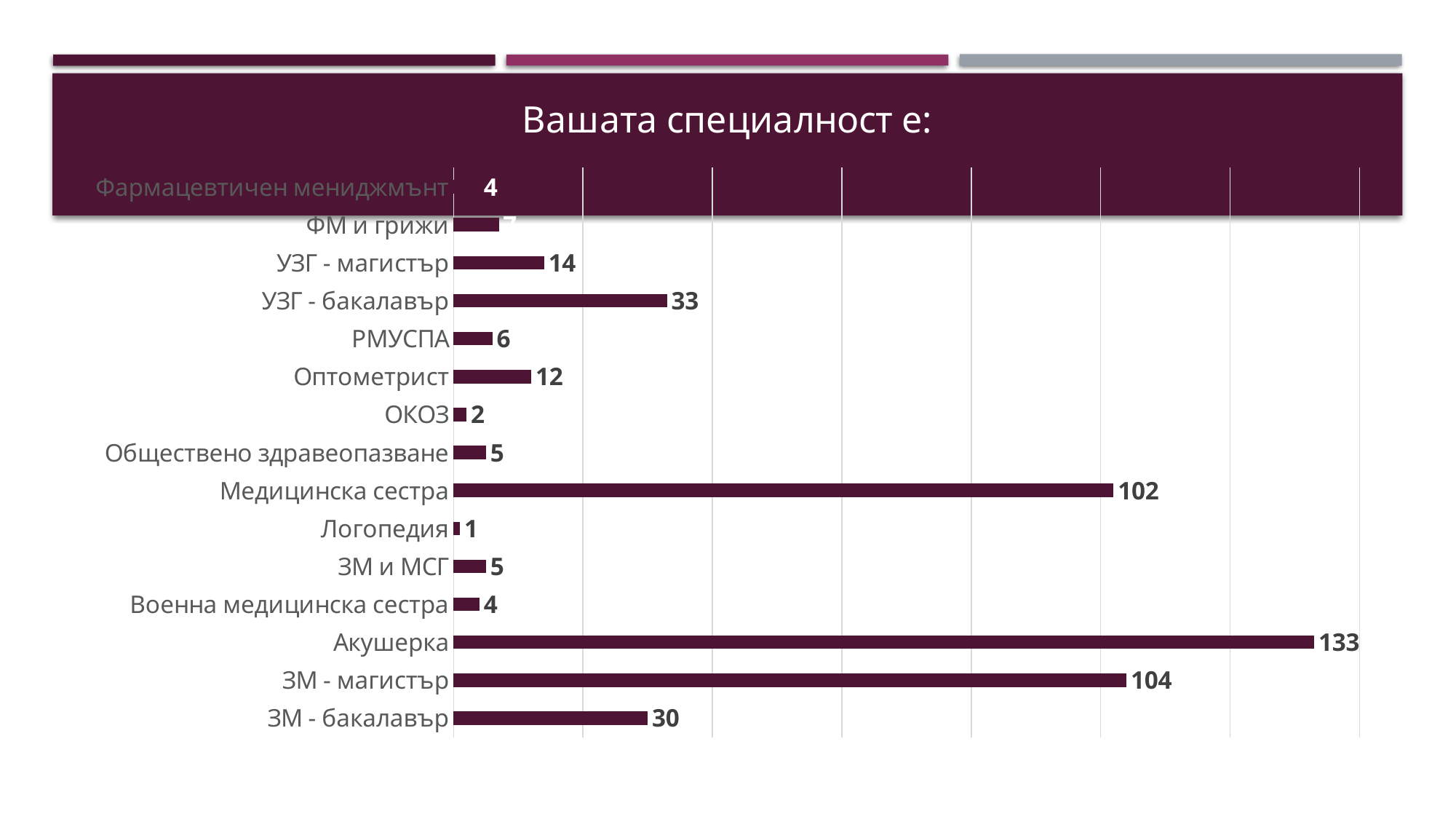
What is the value for УЗГ - бакалавър? 33 Which category has the highest value? Акушерка What type of chart is shown on the slide? bar chart What is the title of the chart? Вашата специалност е: What is the difference between the values for Акушерка and ЗМ - магистър? 29 How many categories are shown in the chart? 15 What is the difference between the values for УЗГ - бакалавър and УЗГ - магистър? 19 What is the value for Медицинска сестра? 102 What is the value for Акушерка? 133 What is the value for Логопедия? 1 Which category has the lowest value? Логопедия Which is larger, the value for ЗМ - магистър or the value for Медицинска сестра? ЗМ - магистър